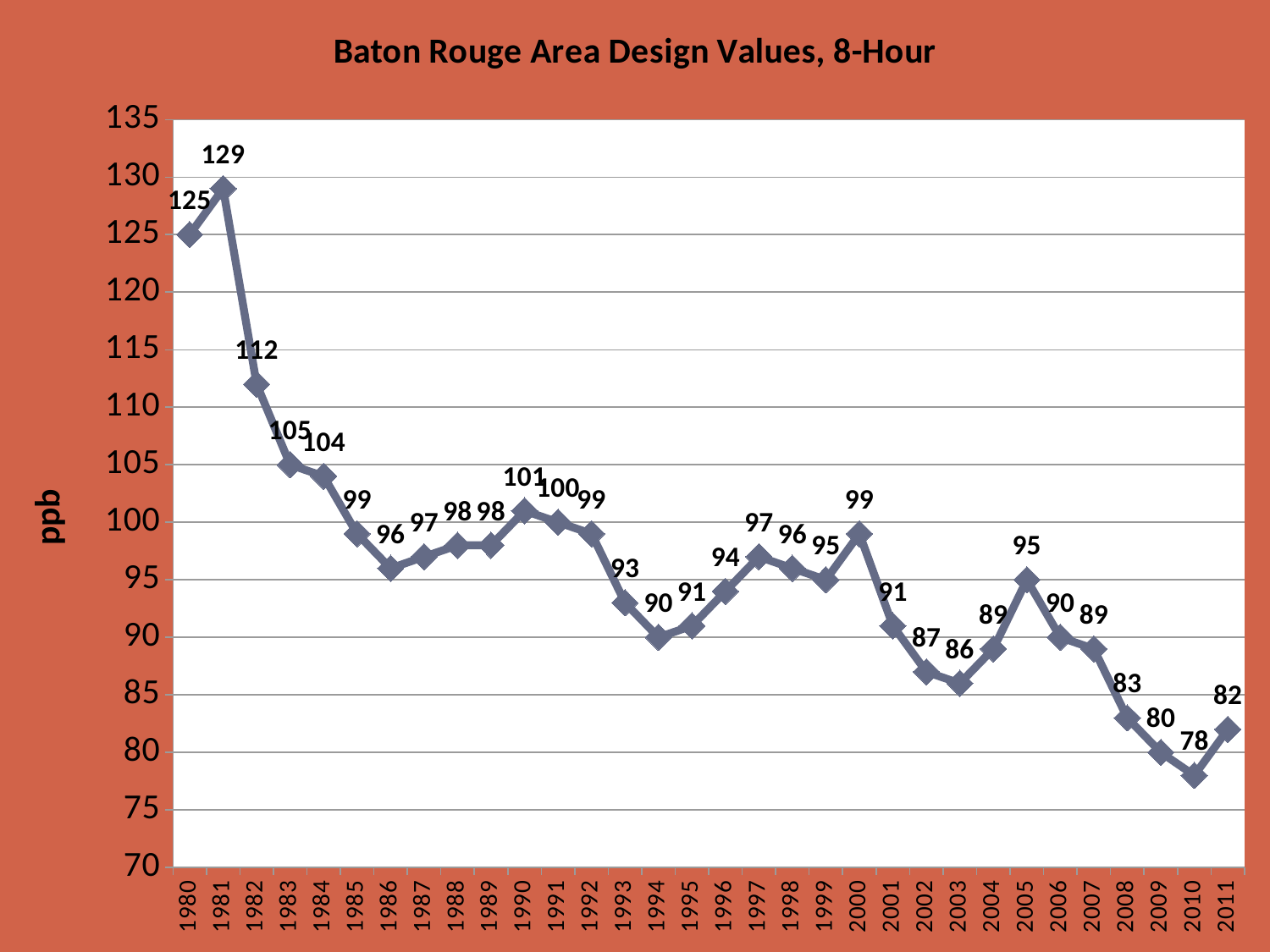
What is the design value for 1981? 129 What is the design value for 1990? 101 What is the design value for 2010? 78 Which year has a larger design value, 2000 or 2005? 2000 Which year has the highest design value? 1981 How many years are plotted on the chart? 32 Do the design values generally rise or fall from 1980 to 2011? fall What is the difference between the design values for 1980 and 2011? 43 Which year has the lowest design value? 2010 What kind of chart is shown on the slide? line chart What is the difference between the design values for 1981 and 1982? 17 Is the design value for 1982 greater or less than 110? greater